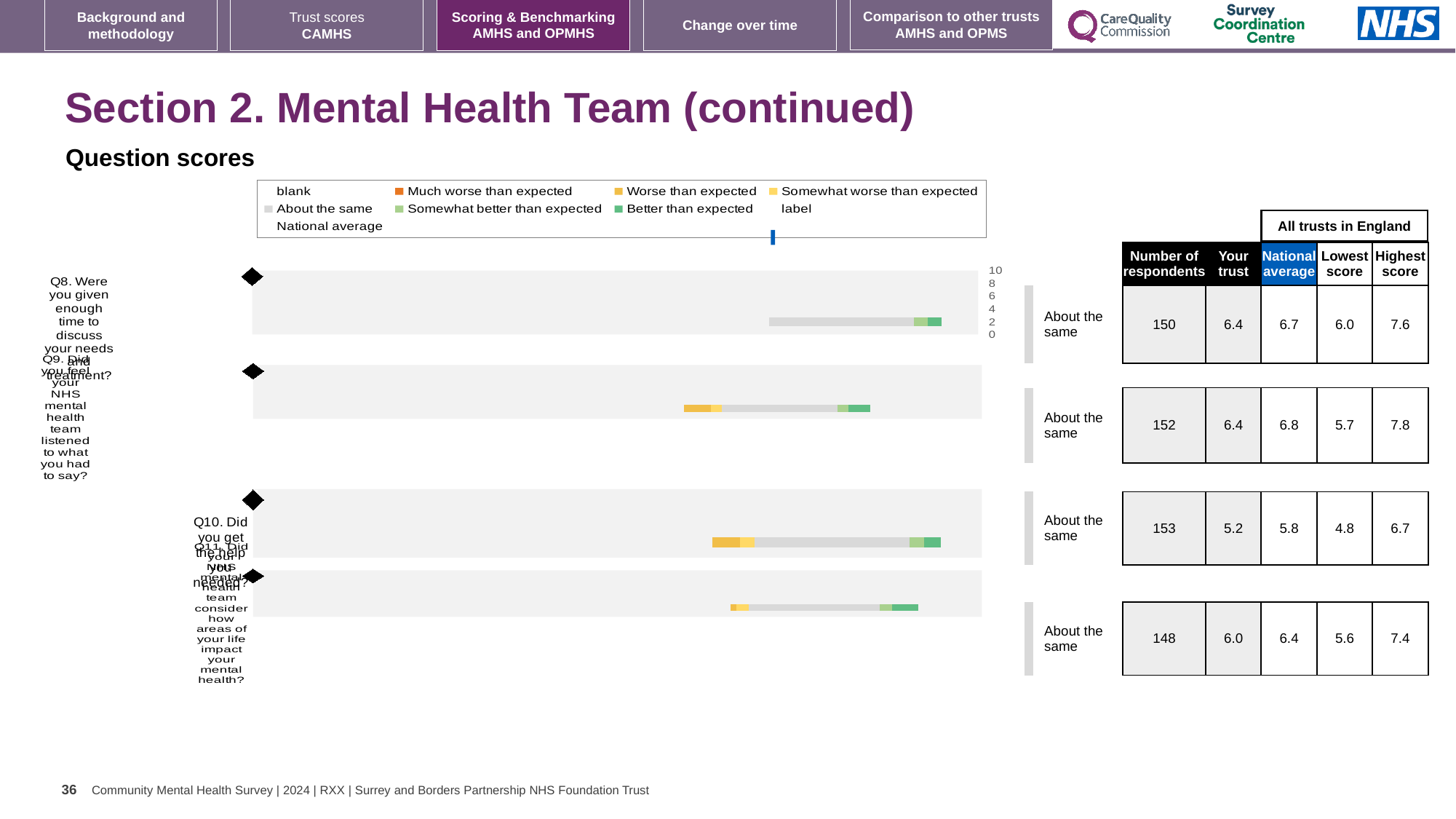
Which has the higher national average, Q9 or Q10? Q9 What is the lowest score across all trusts in England for Q9? 5.7 By how much does the national average for Q8 exceed the 'Your trust' score for Q8? 0.3 How many respondents are listed for Q11? 148 What is the 'Your trust' score for Q10 (Did you get the help you needed)? 5.2 What is the highest score across all trusts in England for Q8? 7.6 Which question has the lowest 'Your trust' score? Q10 How many entries does the legend of the question scores chart list? 9 What heading appears above the 'Lowest score' and 'Highest score' columns? All trusts in England What kind of chart is used to show the question scores on this slide? bar chart How many questions (categories) are plotted in the question scores chart? 4 What is the difference between the highest score and the lowest score for Q10? 1.9